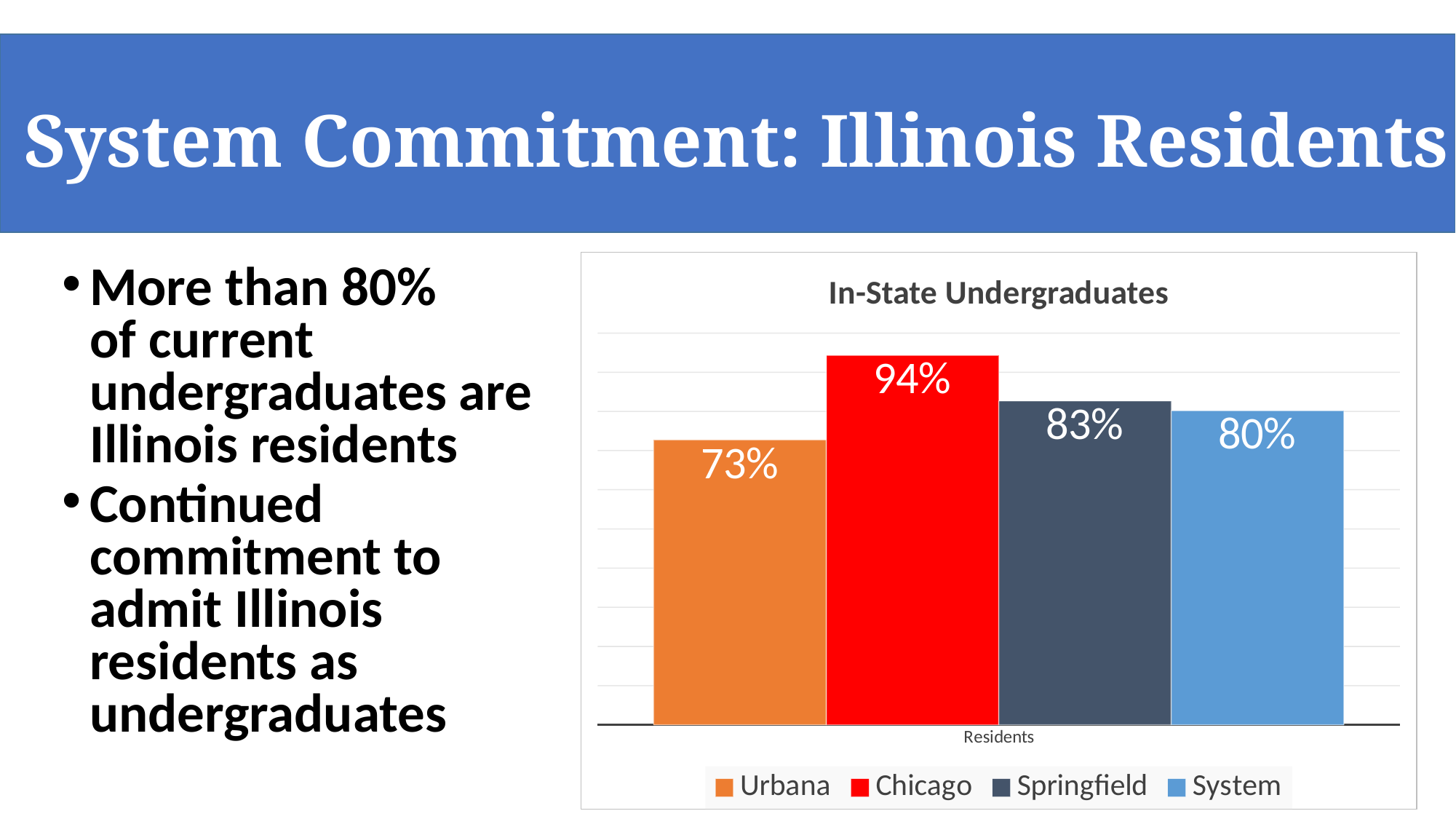
What is the value for Springfield in the In-State Undergraduates chart? 83% What is the difference between the Chicago and Urbana values in the In-State Undergraduates chart? 21% How many series does the legend of the In-State Undergraduates chart list? 4 What is the difference between the Springfield and System values in the In-State Undergraduates chart? 3% What is the value for Chicago in the In-State Undergraduates chart? 94% What kind of chart is the In-State Undergraduates chart? Bar chart Which is larger in the In-State Undergraduates chart, the value for Springfield or the value for System? Springfield Which series has the highest value in the In-State Undergraduates chart? Chicago What is the value for Urbana in the In-State Undergraduates chart? 73% Which series has the lowest value in the In-State Undergraduates chart? Urbana What is the value for System in the In-State Undergraduates chart? 80% What is the title of the chart on the slide? In-State Undergraduates